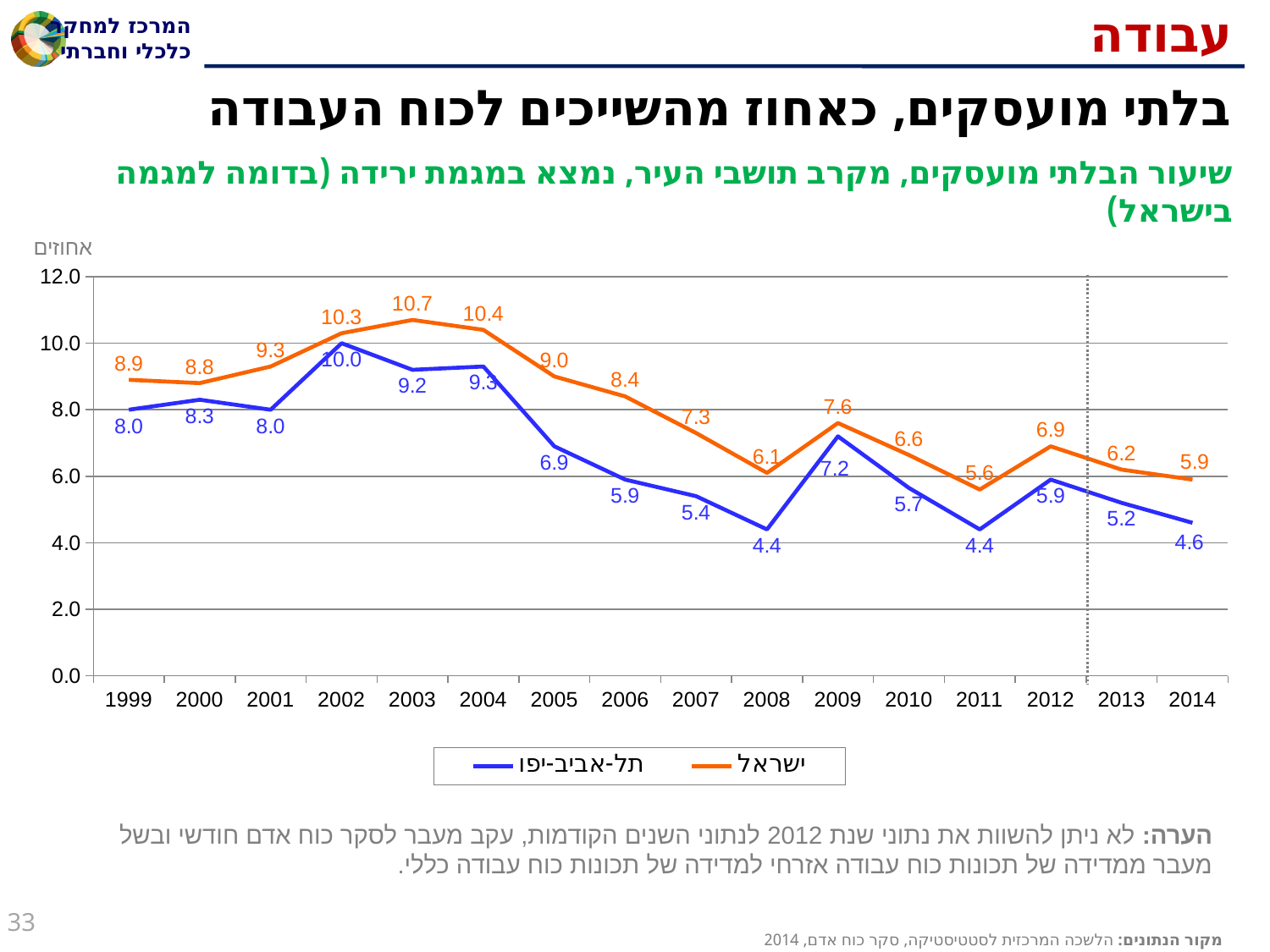
How many years are shown on the x axis? 16 How many series does the legend list? 2 In which year is the value for תל-אביב-יפו highest? 2002 What is the value for תל-אביב-יפו in 2014? 4.6 Overall, do the values for תל-אביב-יפו rise or fall from 1999 to 2014? fall What is the difference between the ישראל and תל-אביב-יפו values in 2014? 1.3 In which year is the value for ישראל highest? 2003 Which series has the larger value in 2009, ישראל or תל-אביב-יפו? ישראל In which year is the value for ישראל lowest? 2011 What type of chart is shown on the slide? line chart What is the value for תל-אביב-יפו in 2008? 4.4 What is the value for ישראל in 2003? 10.7